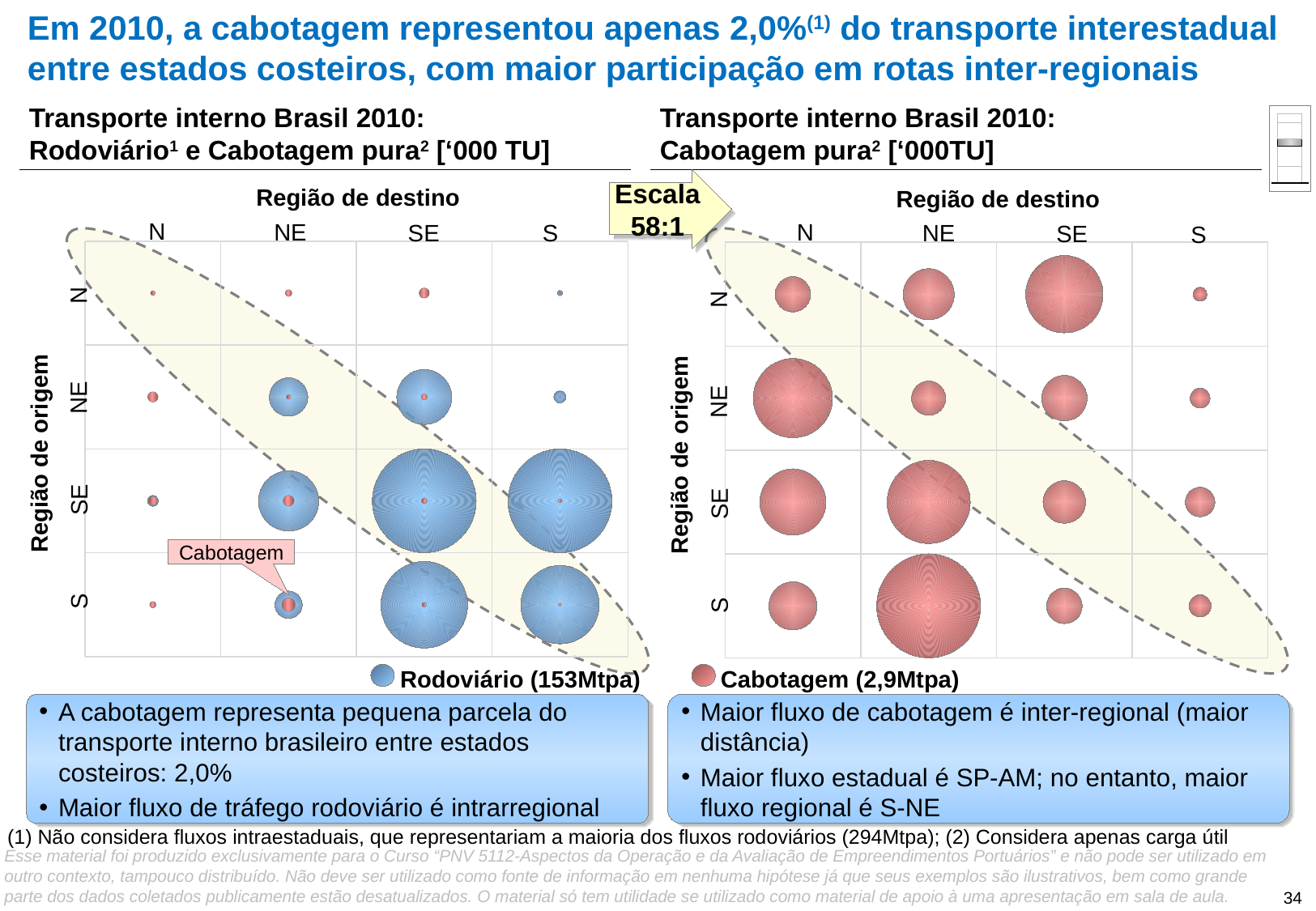
In the right chart (Cabotagem pura), which bubble is larger: origin NE to destination N, or origin NE to destination NE? NE to N In the left chart (Rodoviário e Cabotagem pura), which bubble is larger: origin S to destination NE, or origin S to destination SE? S to SE In the left chart (Rodoviário e Cabotagem pura), which origin region has the smallest bubbles overall? N According to the legend, what total is given for the Cabotagem series? 2,9Mtpa How many destination regions are shown along the x axis of the right chart, 'Transporte interno Brasil 2010: Cabotagem pura'? 4 According to the legend, what total is given for the Rodoviário series? 153Mtpa How many series does the legend below the charts list? 2 In the right chart (Cabotagem pura), which origin-destination pair has the largest bubble? S to NE What scale ratio is shown between the left and right charts? 58:1 What colour are the Cabotagem bubbles in the charts? Red What kind of chart is the left chart, 'Transporte interno Brasil 2010: Rodoviário e Cabotagem pura'? Bubble chart In the right chart (Cabotagem pura), which origin-destination pair has the smallest bubble? N to S